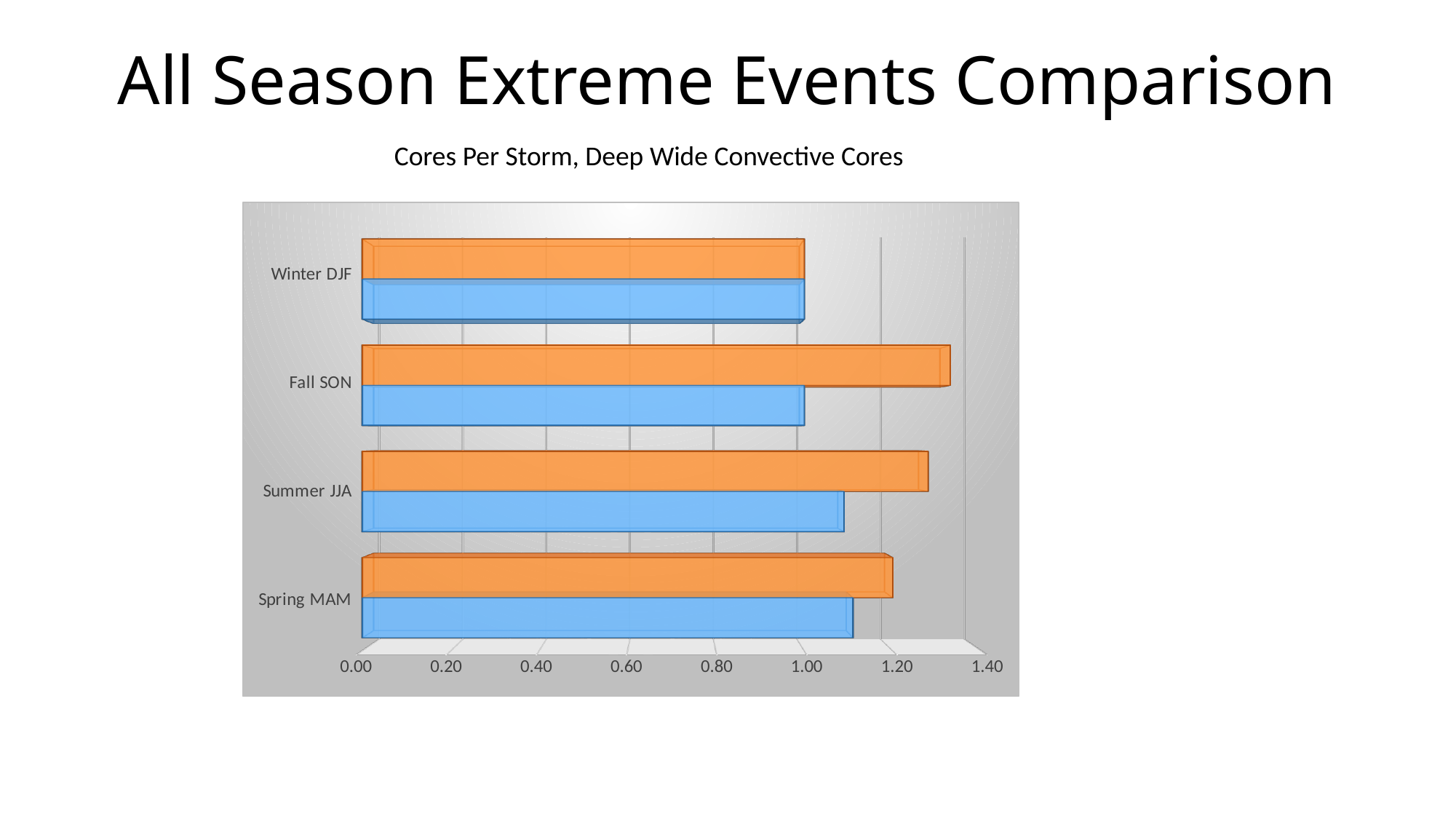
For Spring MAM, which bar is longer, the orange one or the blue one? orange What is the subtitle shown above the chart? Cores Per Storm, Deep Wide Convective Cores Is the blue bar for Spring MAM greater or less than 1.20? less What kind of chart is shown on the slide? bar chart How many bars are plotted for each season category? 2 For Fall SON, which bar is longer, the orange one or the blue one? orange Is the orange bar for Fall SON greater or less than 1.20? greater Is the orange bar for Summer JJA greater or less than 1.20? greater How many season categories are shown on the chart? 4 Which season has the shortest orange bar? Winter DJF Which season has the longest orange bar? Fall SON